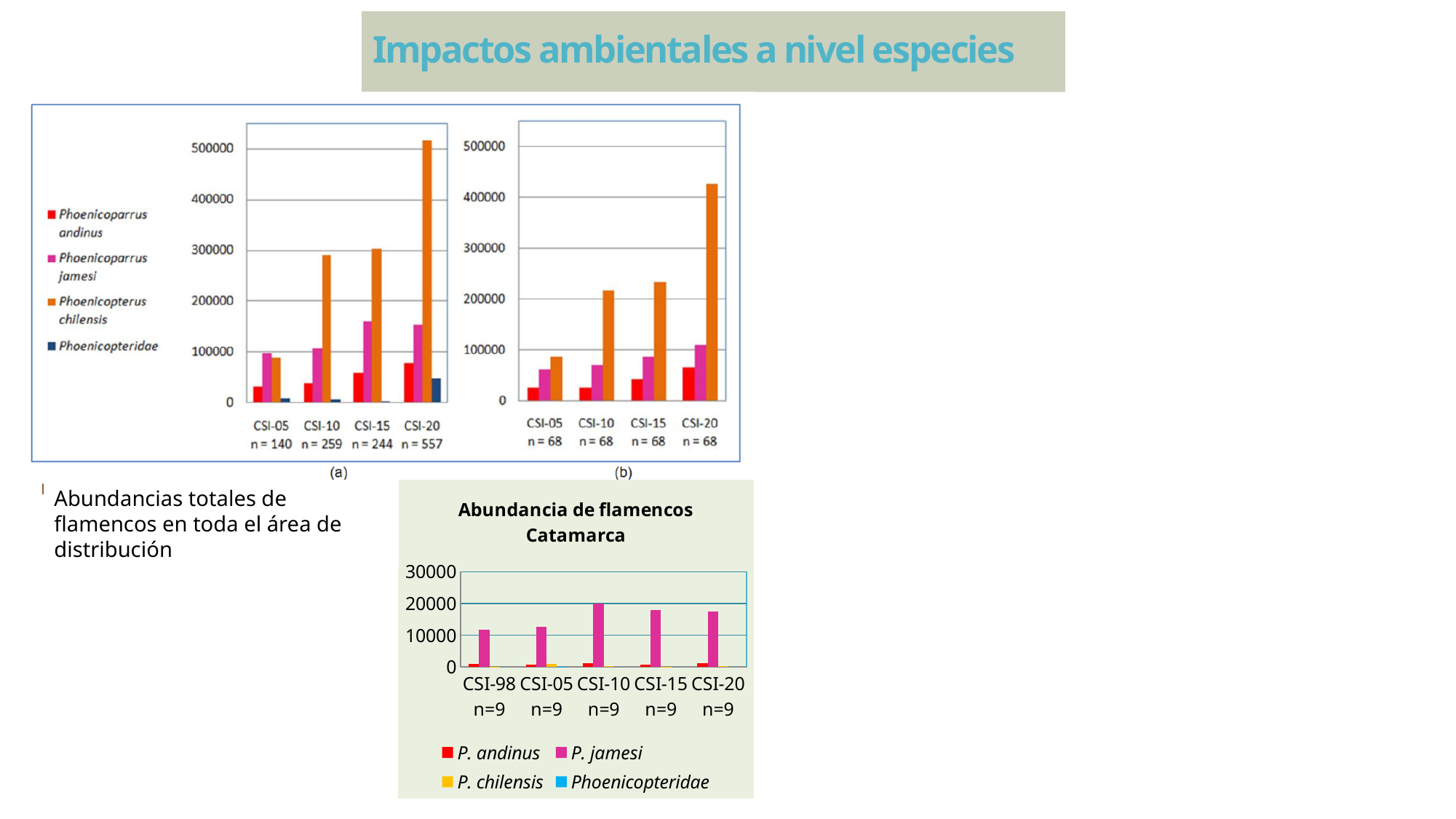
In the chart labelled (a), is the value for Phoenicopterus chilensis at CSI-10 greater or less than 200000? greater In the chart labelled (a), how many series does the legend list? 4 In the chart titled 'Abundancia de flamencos Catamarca', how many categories are shown on the x axis? 5 In the chart labelled (a), which category has the highest value for Phoenicopterus chilensis? CSI-20 What kind of chart is the chart labelled (a)? bar chart In the chart labelled (b), is the value for Phoenicopterus chilensis at CSI-20 greater or less than 400000? greater In the chart labelled (a), how many categories are shown on the x axis? 4 In the chart titled 'Abundancia de flamencos Catamarca', which category has the highest value for P. jamesi? CSI-10 In the chart labelled (a), is the value for Phoenicoparrus andinus at CSI-05 greater or less than 100000? less In the chart labelled (a), which is larger at CSI-15: Phoenicoparrus jamesi or Phoenicoparrus andinus? Phoenicoparrus jamesi In the chart labelled (b), do the values for Phoenicopterus chilensis rise or fall from CSI-05 to CSI-20? rise